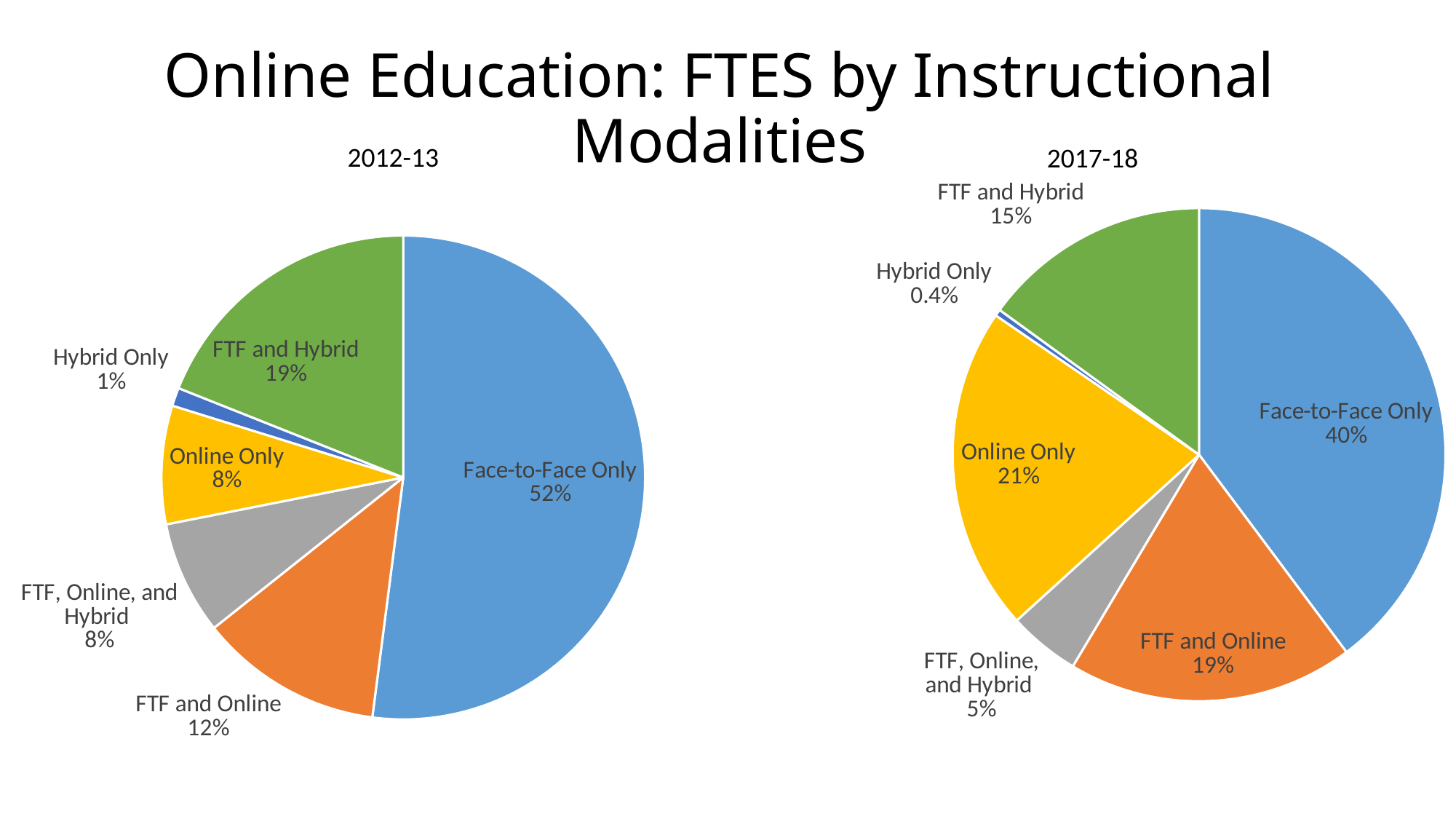
In the 2012-13 chart, what share of FTES is Face-to-Face Only? 52% In the 2017-18 chart, which is larger: Online Only or FTF and Online? Online Only In the 2017-18 chart, which modality has the smallest share? Hybrid Only How many slices does the 2012-13 pie chart have? 6 In the 2017-18 chart, what share of FTES is Online Only? 21% In the 2017-18 chart, what share of FTES is Hybrid Only? 0.4% In the 2012-13 chart, what share of FTES is FTF and Online? 12% What type of chart is used on this slide? Pie chart What is the title of the slide? Online Education: FTES by Instructional Modalities In the 2012-13 chart, which modality has the smallest share? Hybrid Only What is the difference between the Face-to-Face Only share in 2012-13 and in 2017-18? 12 percentage points In the 2017-18 chart, which modality has the largest share? Face-to-Face Only